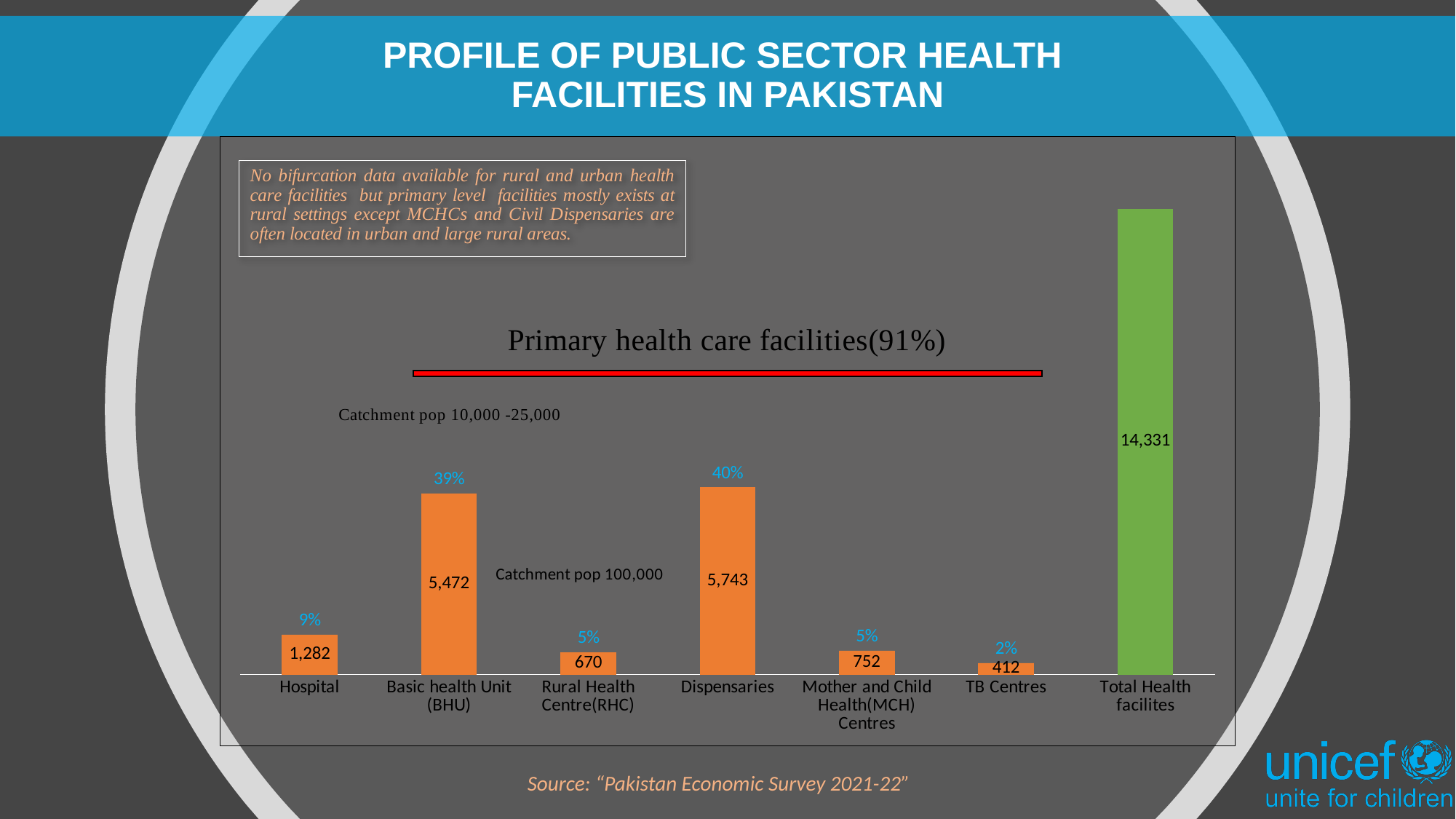
Which is larger, the value for Mother and Child Health(MCH) Centres or the value for Rural Health Centre(RHC)? Mother and Child Health(MCH) Centres What is the difference between the values for Dispensaries and Basic health Unit (BHU)? 271 What is the value shown for Hospital? 1,282 Excluding the Total Health facilites bar, which category has the highest value? Dispensaries What is the value shown for Dispensaries? 5,743 How many categories are shown on the x axis of the chart? 7 Which category has the lowest value? TB Centres What colour is the Total Health facilites bar? Green What percentage is shown above the Basic health Unit (BHU) bar? 39% What percentage is shown above the TB Centres bar? 2% What kind of chart is shown on the slide? Bar chart What is the value shown for Total Health facilites? 14,331